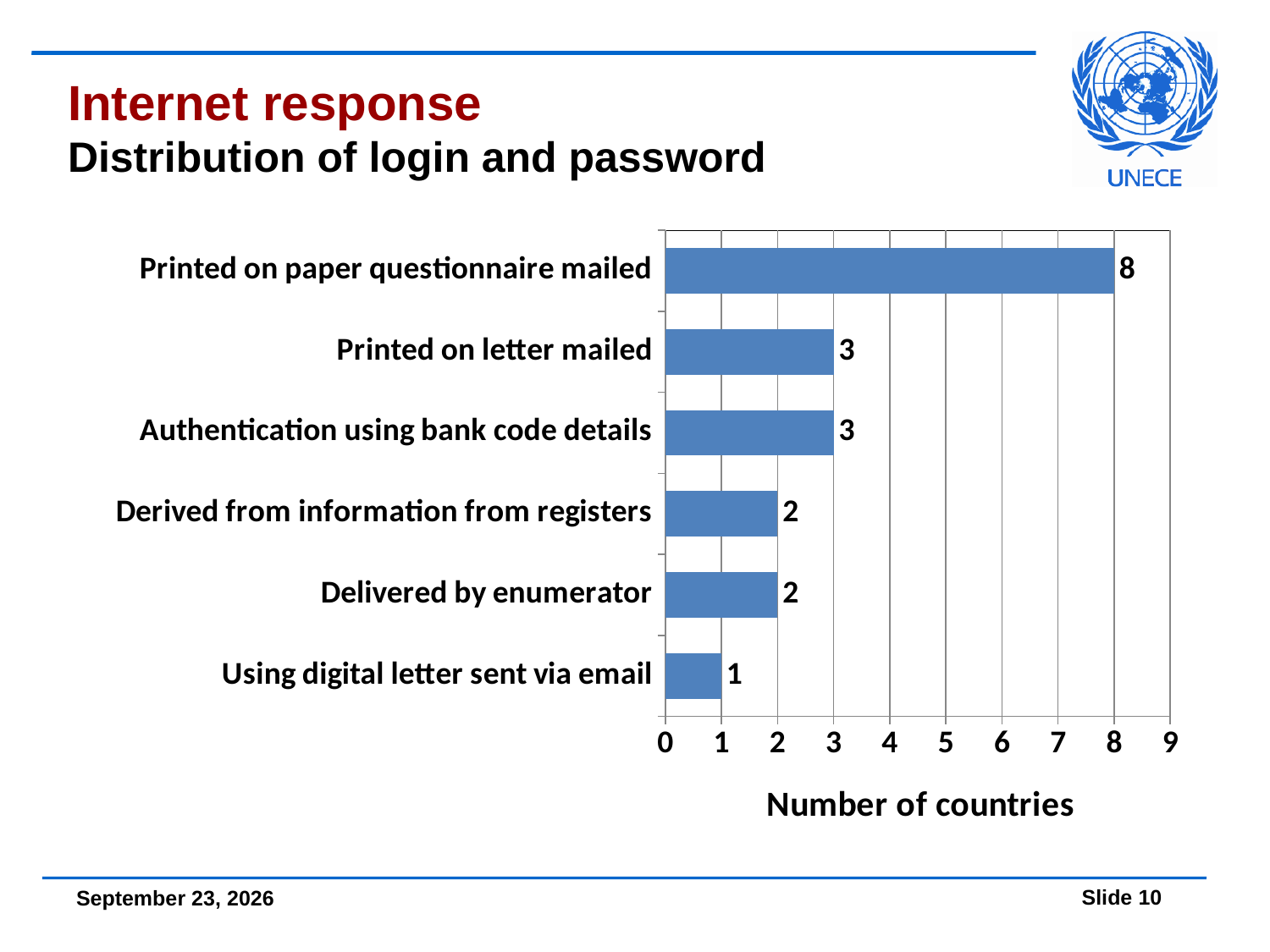
What is the label of the horizontal axis? Number of countries Which category has the lowest number of countries? Using digital letter sent via email What is the difference between 'Printed on paper questionnaire mailed' and 'Printed on letter mailed'? 5 What is the value for 'Printed on letter mailed'? 3 What kind of chart is shown on the slide? Bar chart How many categories are shown in the chart? 6 How many countries used a digital letter sent via email? 1 Which is larger: 'Authentication using bank code details' or 'Derived from information from registers'? Authentication using bank code details Which category has the highest number of countries? Printed on paper questionnaire mailed How many countries printed the login and password on the paper questionnaire mailed? 8 Is the value for 'Printed on paper questionnaire mailed' greater or less than 5? greater What is the value for 'Delivered by enumerator'? 2